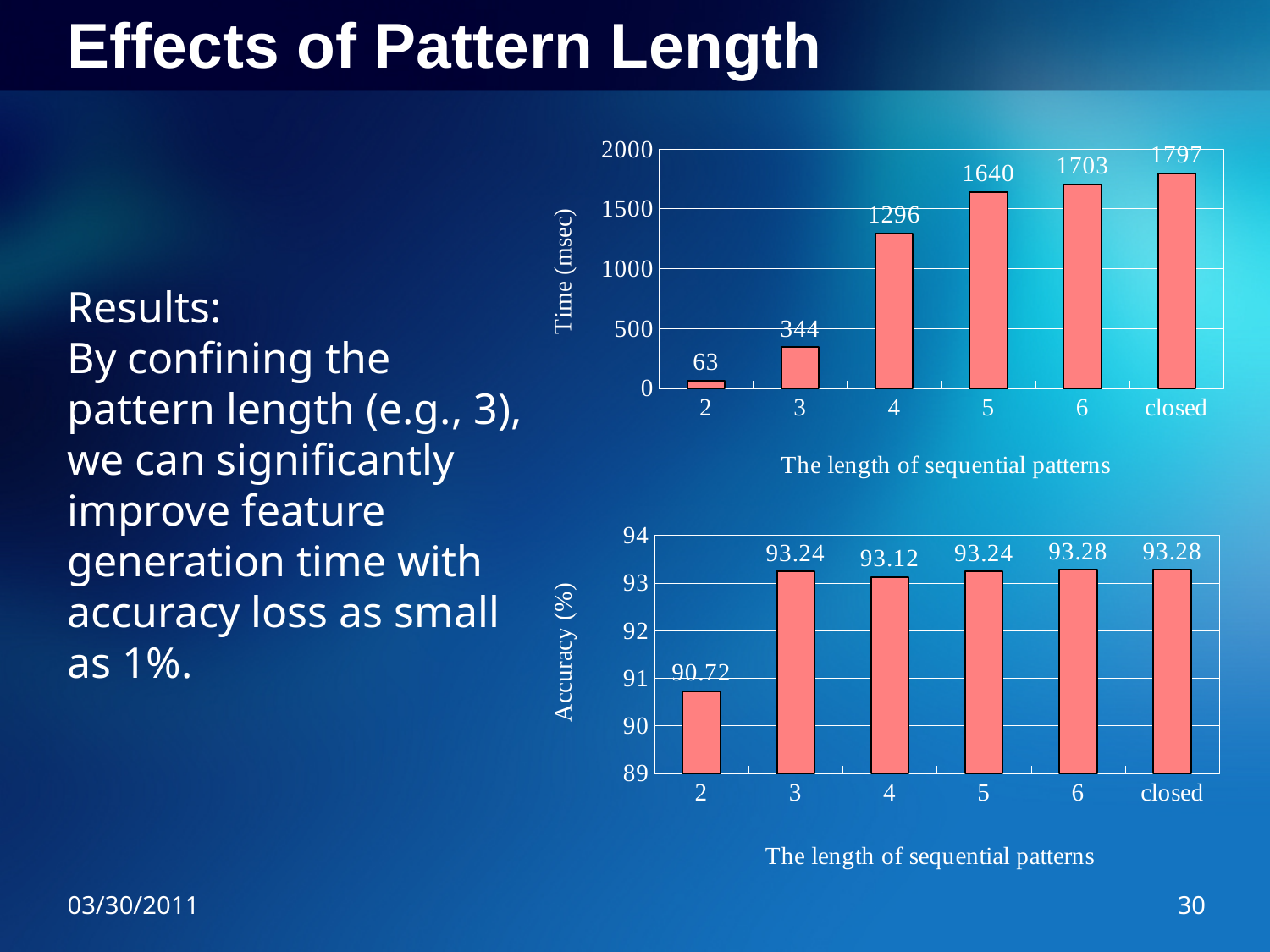
In the top chart (Time (msec)), what is the difference in time between pattern length 4 and pattern length 3? 952 In the top chart (Time (msec)), do the values rise or fall as the pattern length increases along the x axis? rise What type of chart is the top chart (Time (msec))? bar chart In the top chart (Time (msec)), what is the time for the 'closed' category? 1797 In the top chart (Time (msec)), what is the time for pattern length 3? 344 In the bottom chart (Accuracy (%)), what is the accuracy for pattern length 2? 90.72 How many categories are shown on the x axis of the bottom chart (Accuracy (%))? 6 In the top chart (Time (msec)), is the value for pattern length 5 greater or less than 1500? greater In the bottom chart (Accuracy (%)), which is larger, the accuracy for pattern length 3 or pattern length 4? 3 In the bottom chart (Accuracy (%)), what is the accuracy for pattern length 4? 93.12 In the top chart (Time (msec)), which category has the lowest time? 2 In the bottom chart (Accuracy (%)), what is the difference in accuracy between 'closed' and pattern length 2? 2.56